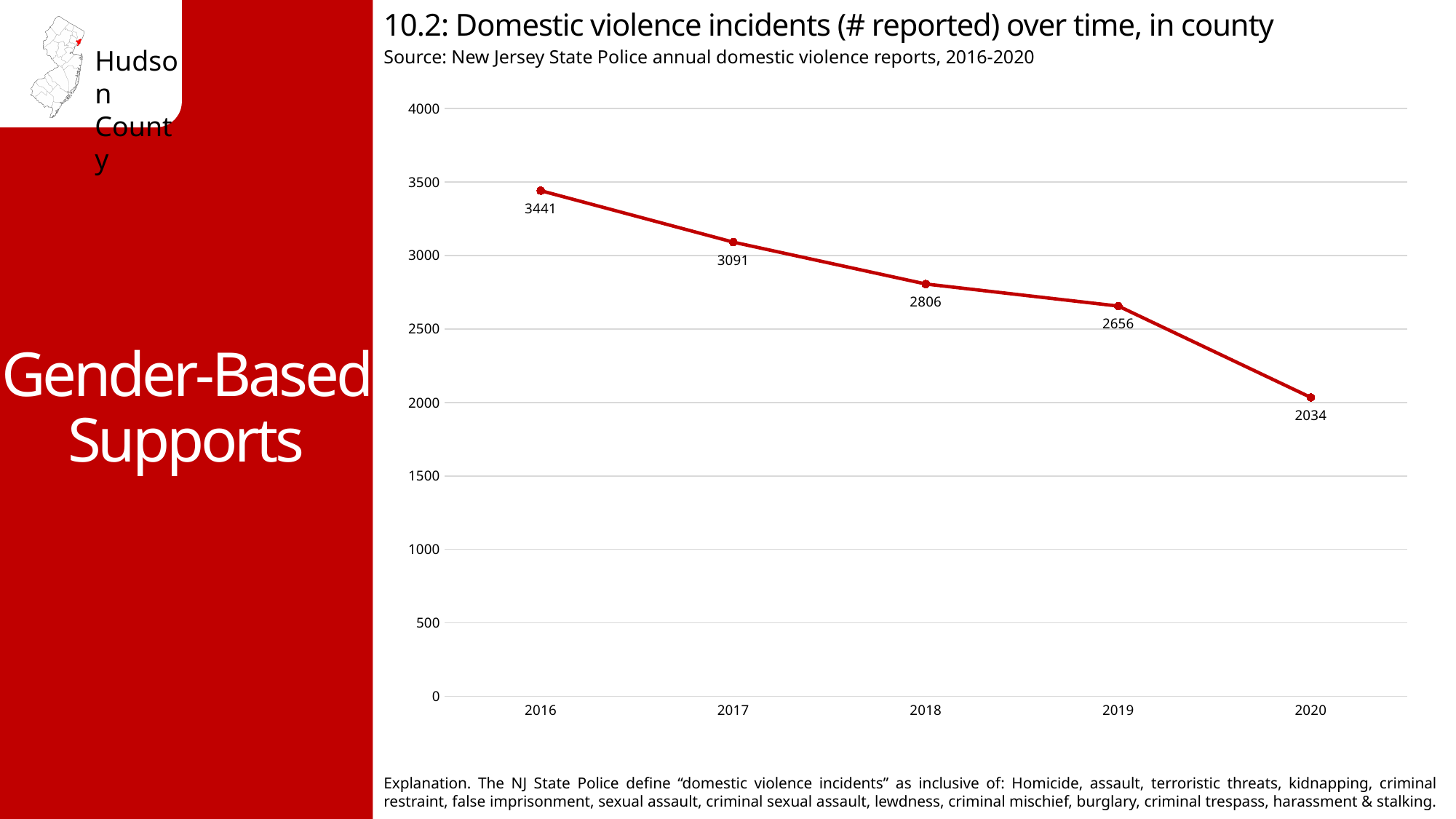
What kind of chart is shown on the slide? line chart What is the difference in reported incidents between 2017 and 2018? 285 Which year had the lowest number of reported domestic violence incidents? 2020 What is the difference in reported incidents between 2016 and 2020? 1407 How many years are plotted on the chart? 5 Which year had more reported incidents, 2017 or 2019? 2017 Which year had the highest number of reported domestic violence incidents? 2016 Is the value for 2019 greater or less than 3000? less What was the number of reported domestic violence incidents in 2018? 2806 Do the reported incidents rise or fall from 2016 to 2020? fall What was the number of reported domestic violence incidents in 2020? 2034 What was the number of reported domestic violence incidents in 2016? 3441